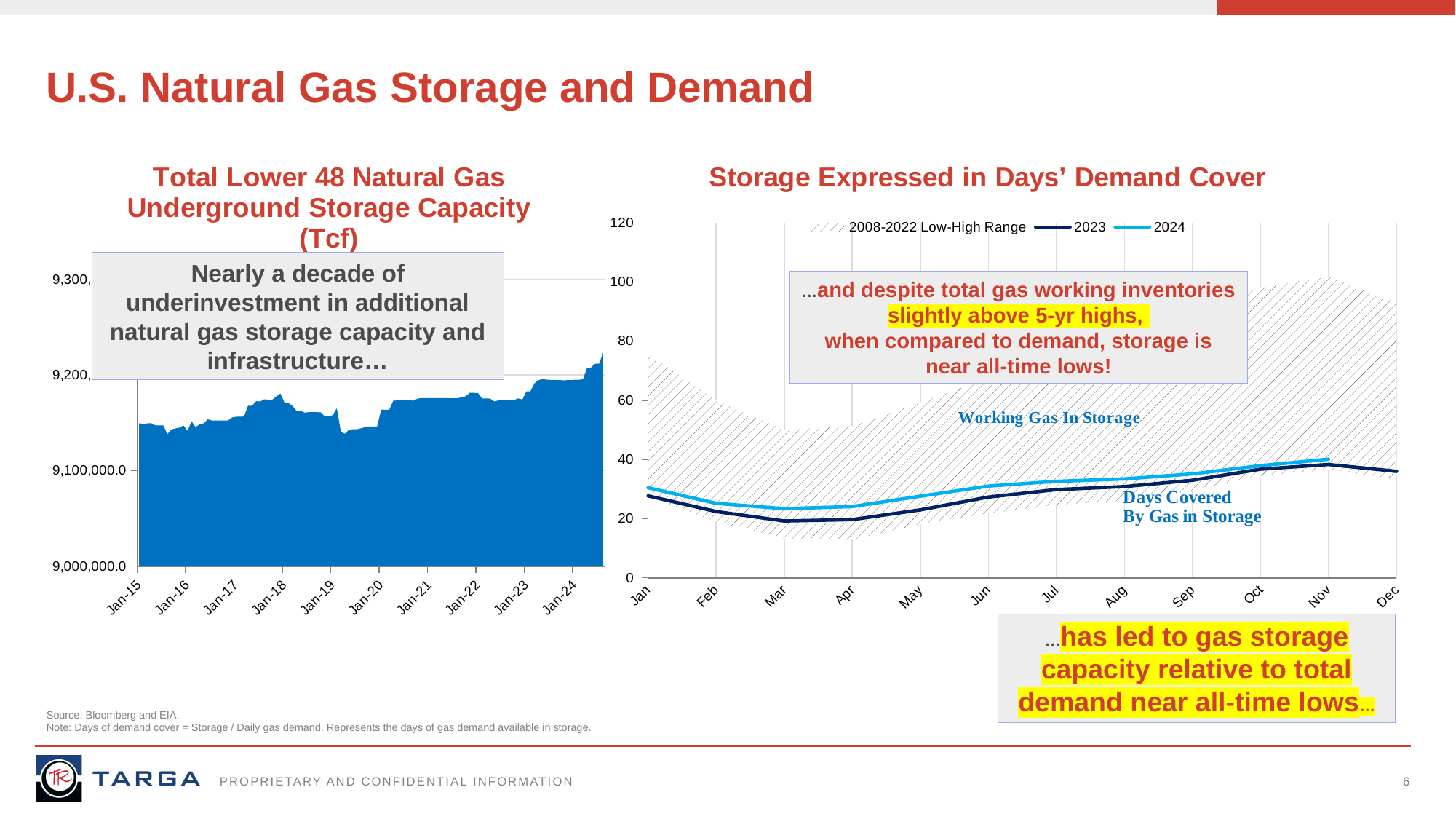
In the 'Storage Expressed in Days' Demand Cover' chart, is the 2024 value in Jan greater or less than 20? Greater In the 'Storage Expressed in Days' Demand Cover' chart, in which month is the 2024 line at its lowest? Mar In the 'Storage Expressed in Days' Demand Cover' chart, what does the hatched area in the legend represent? 2008-2022 Low-High Range In the 'Storage Expressed in Days' Demand Cover' chart, is the 2023 value in Jan greater or less than 40? Less What kind of chart is the left chart, 'Total Lower 48 Natural Gas Underground Storage Capacity (Tcf)'? Area chart In the 'Storage Expressed in Days' Demand Cover' chart, how many months are labelled on the x axis? 12 In the 'Storage Expressed in Days' Demand Cover' chart, how many entries does the legend list? 3 In the 'Storage Expressed in Days' Demand Cover' chart, does the 2024 line rise or fall from Mar to Nov? Rise In the 'Total Lower 48 Natural Gas Underground Storage Capacity (Tcf)' chart, how many year labels are shown on the x axis? 10 In the 'Total Lower 48 Natural Gas Underground Storage Capacity (Tcf)' chart, does storage capacity generally rise or fall from Jan-15 to Jan-24? Rise What kind of chart is the right chart, 'Storage Expressed in Days' Demand Cover'? Combination area and line chart In the 'Storage Expressed in Days' Demand Cover' chart, which is higher in Mar, the 2023 line or the 2024 line? 2024